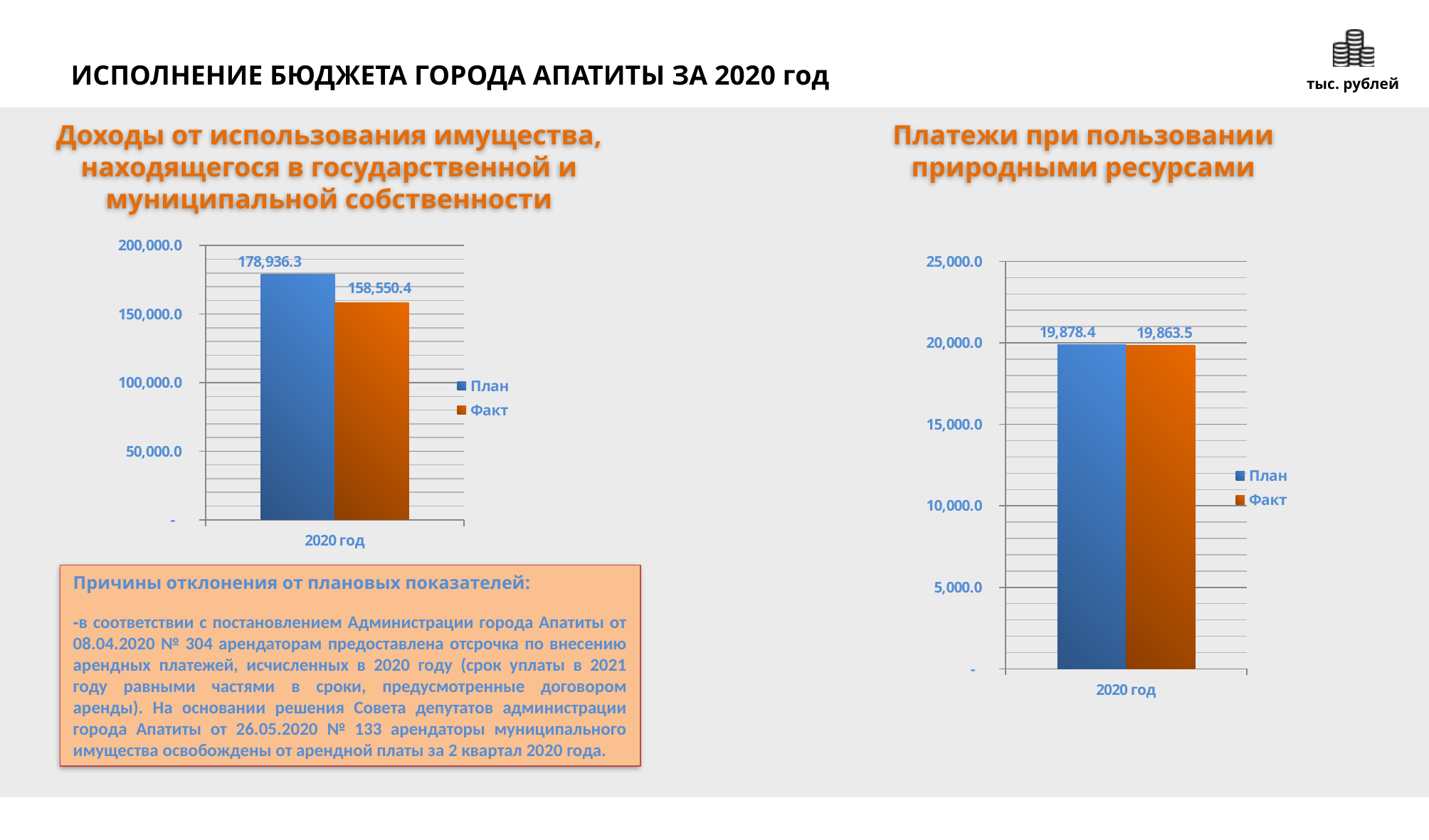
In the right chart (Платежи при пользовании природными ресурсами), what is the value for План? 19,878.4 In the left chart (Доходы от использования имущества), which series has the higher value, План or Факт? План In the left chart (Доходы от использования имущества), is the value for Факт greater or less than 150,000.0? greater What kind of chart is the left chart (Доходы от использования имущества)? bar chart In the left chart (Доходы от использования имущества), what is the value for Факт in 2020 год? 158,550.4 In the left chart (Доходы от использования имущества), what is the value for План in 2020 год? 178,936.3 In the right chart (Платежи при пользовании природными ресурсами), what is the value for Факт? 19,863.5 In the right chart (Платежи при пользовании природными ресурсами), is the value for Факт greater or less than 15,000.0? greater How many series does the legend of the right chart (Платежи при пользовании природными ресурсами) list? 2 What unit of measurement is indicated in the top right corner of the slide? тыс. рублей In the left chart (Доходы от использования имущества), what is the difference between План and Факт? 20,385.9 In the right chart (Платежи при пользовании природными ресурсами), what is the difference between План and Факт? 14.9